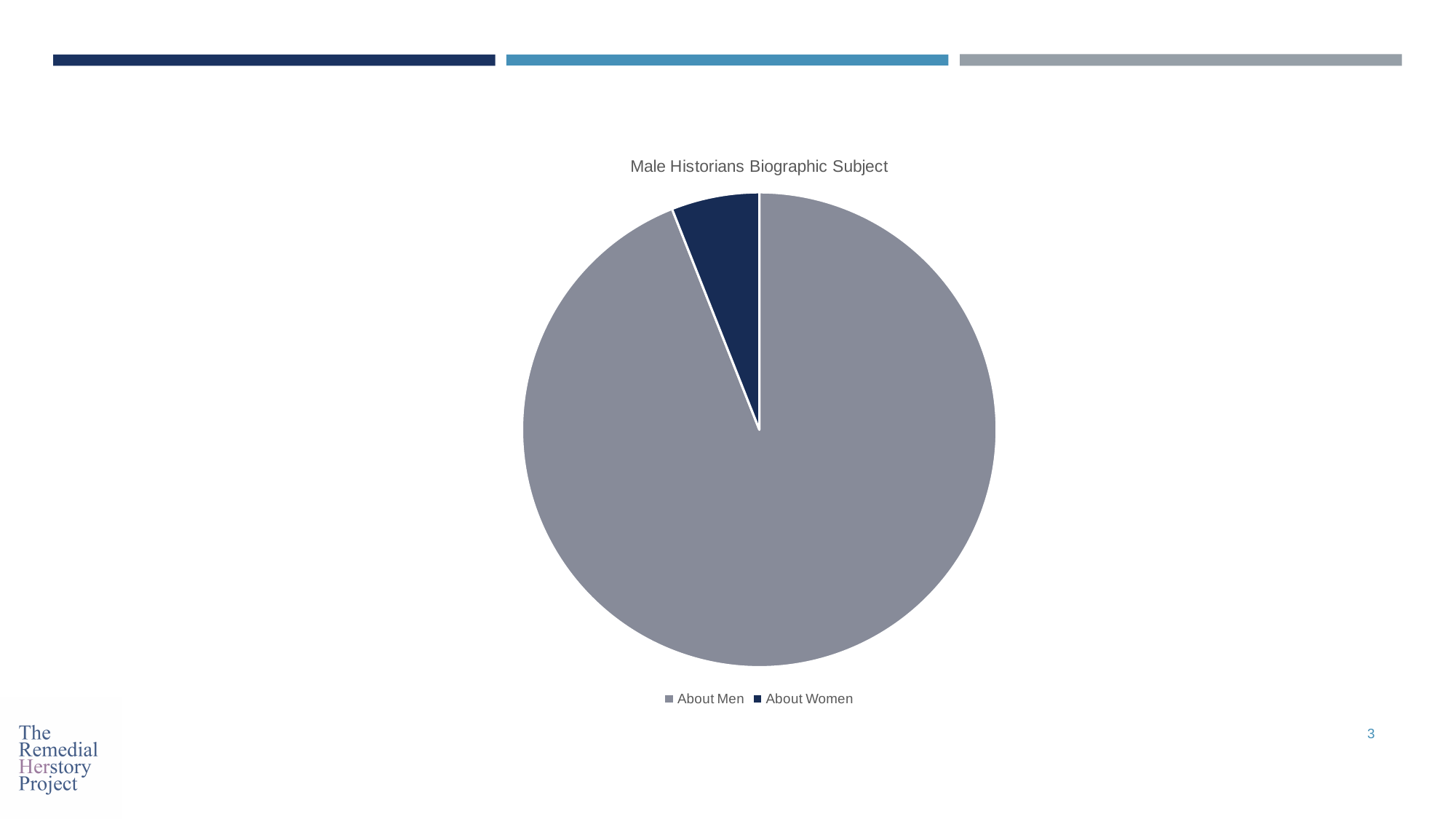
What colour is the About Women slice? Dark navy blue How many slices does the pie chart have? 2 How many entries does the legend list? 2 Which category has the smallest slice of the pie? About Women Which is larger, the slice for About Men or the slice for About Women? About Men Which category has the largest slice of the pie? About Men What is the title of the chart? Male Historians Biographic Subject What kind of chart is shown on the slide? Pie chart